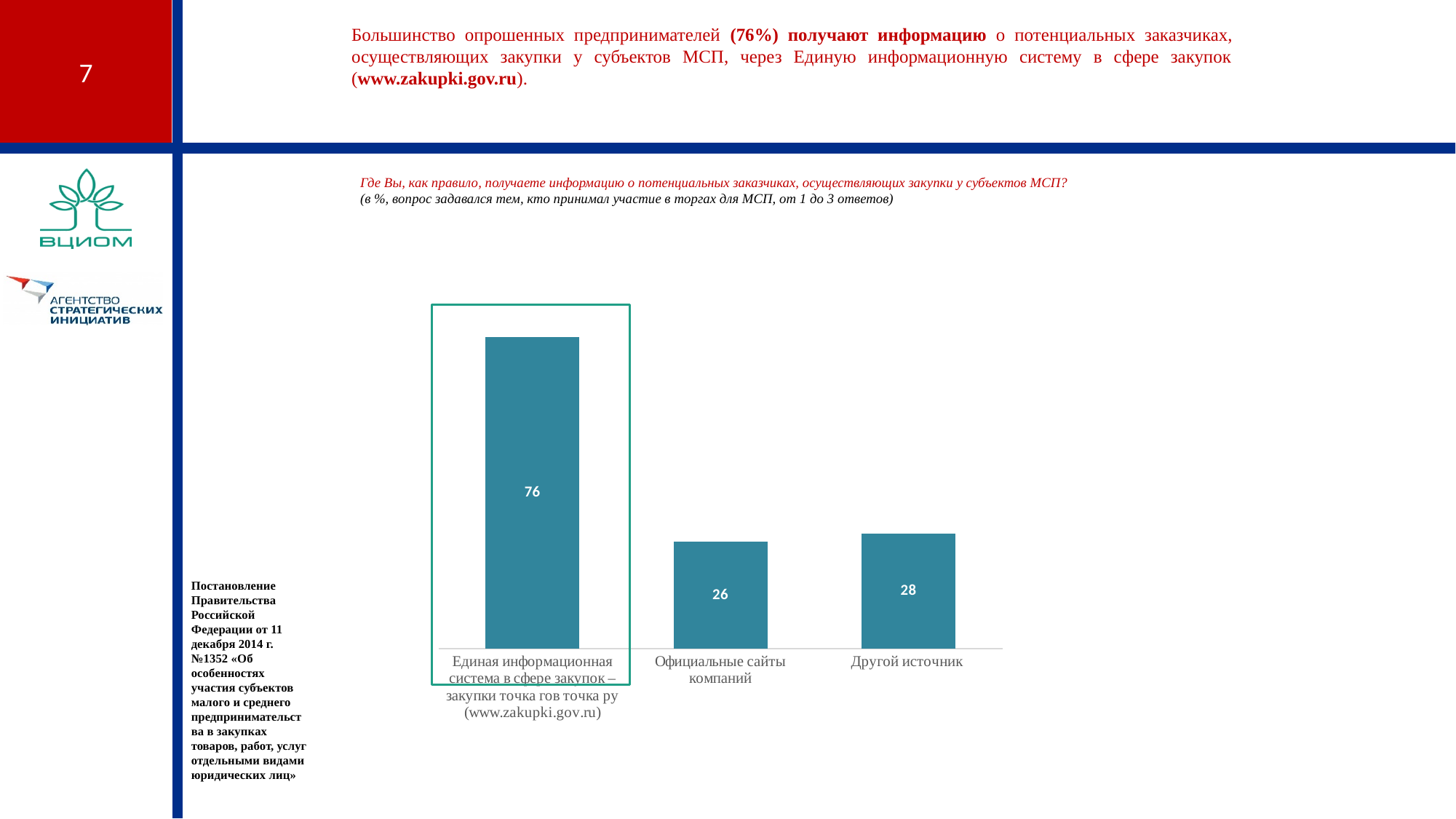
How many categories are shown in the chart? 3 What is the value for "Единая информационная система в сфере закупок" (www.zakupki.gov.ru)? 76 Which category has the highest value? Единая информационная система в сфере закупок (www.zakupki.gov.ru) What kind of chart is shown on the slide? Bar chart What is the difference between the values for "Единая информационная система в сфере закупок" and "Другой источник"? 48 Which is larger: the value for "Единая информационная система в сфере закупок" or for "Официальные сайты компаний"? Единая информационная система в сфере закупок Which category has the lowest value? Официальные сайты компаний What is the value for "Другой источник"? 28 What is the value for "Официальные сайты компаний"? 26 What colour are the bars in the chart? Teal Which category's bar is outlined with a green box? Единая информационная система в сфере закупок (www.zakupki.gov.ru) What is the difference between the values for "Другой источник" and "Официальные сайты компаний"? 2